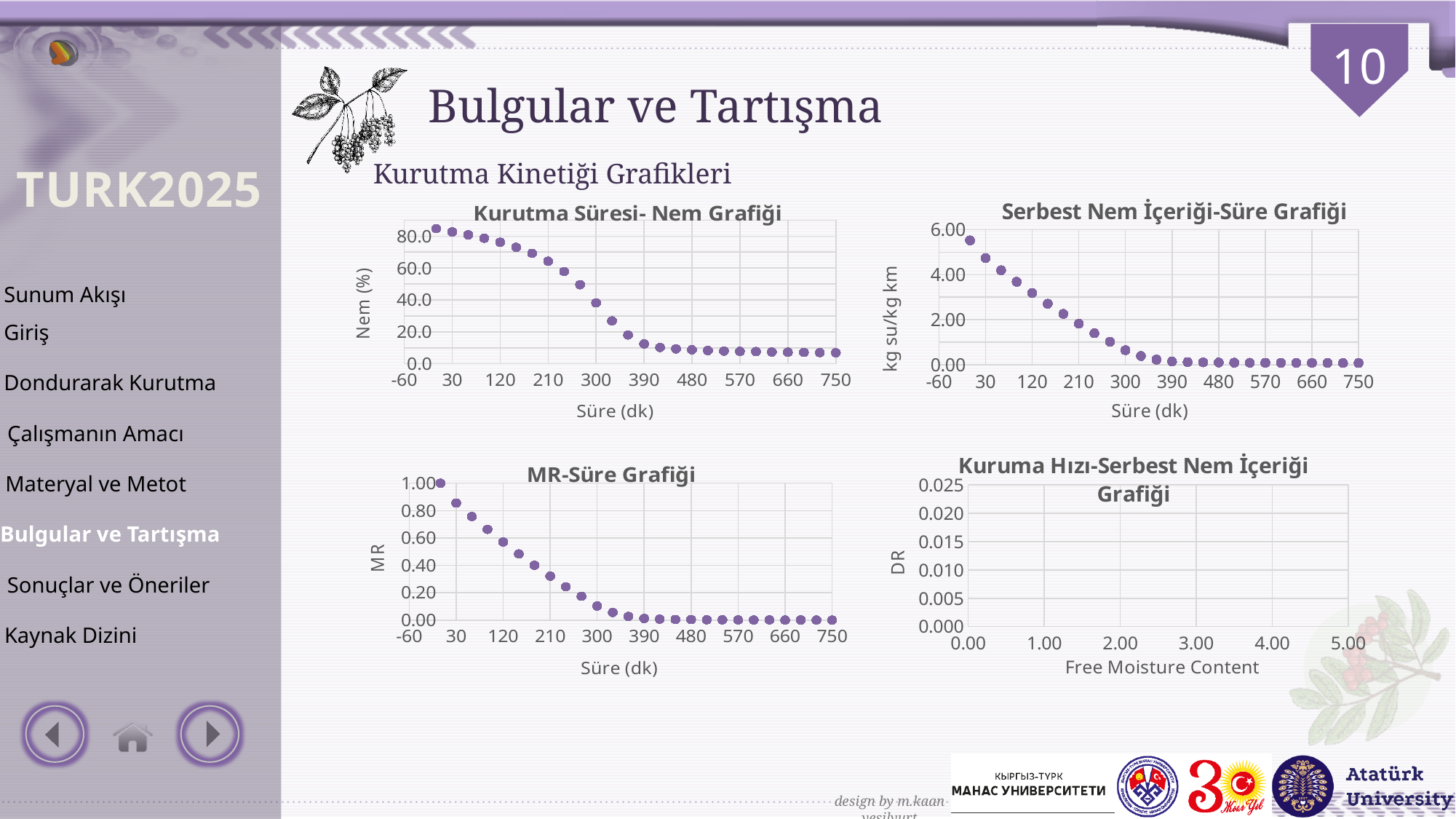
What is the x-axis title of the "Kuruma Hızı-Serbest Nem İçeriği Grafiği" chart? Free Moisture Content In the "Kurutma Süresi- Nem Grafiği" chart, do the values rise or fall as Süre (dk) increases? fall In the "MR-Süre Grafiği" chart, is the MR value at Süre 30 greater or less than 0.60? greater In the "MR-Süre Grafiği" chart, is the MR value at Süre 750 greater or less than 0.20? less In the "MR-Süre Grafiği" chart, do the MR values rise or fall as Süre (dk) increases? fall What kind of chart is the "Kurutma Süresi- Nem Grafiği" chart? scatter chart In the "Kurutma Süresi- Nem Grafiği" chart, is the Nem (%) value at Süre 30 greater or less than 60.0? greater In the "Serbest Nem İçeriği-Süre Grafiği" chart, do the values rise or fall as Süre (dk) increases? fall What is the y-axis title of the "Serbest Nem İçeriği-Süre Grafiği" chart? kg su/kg km